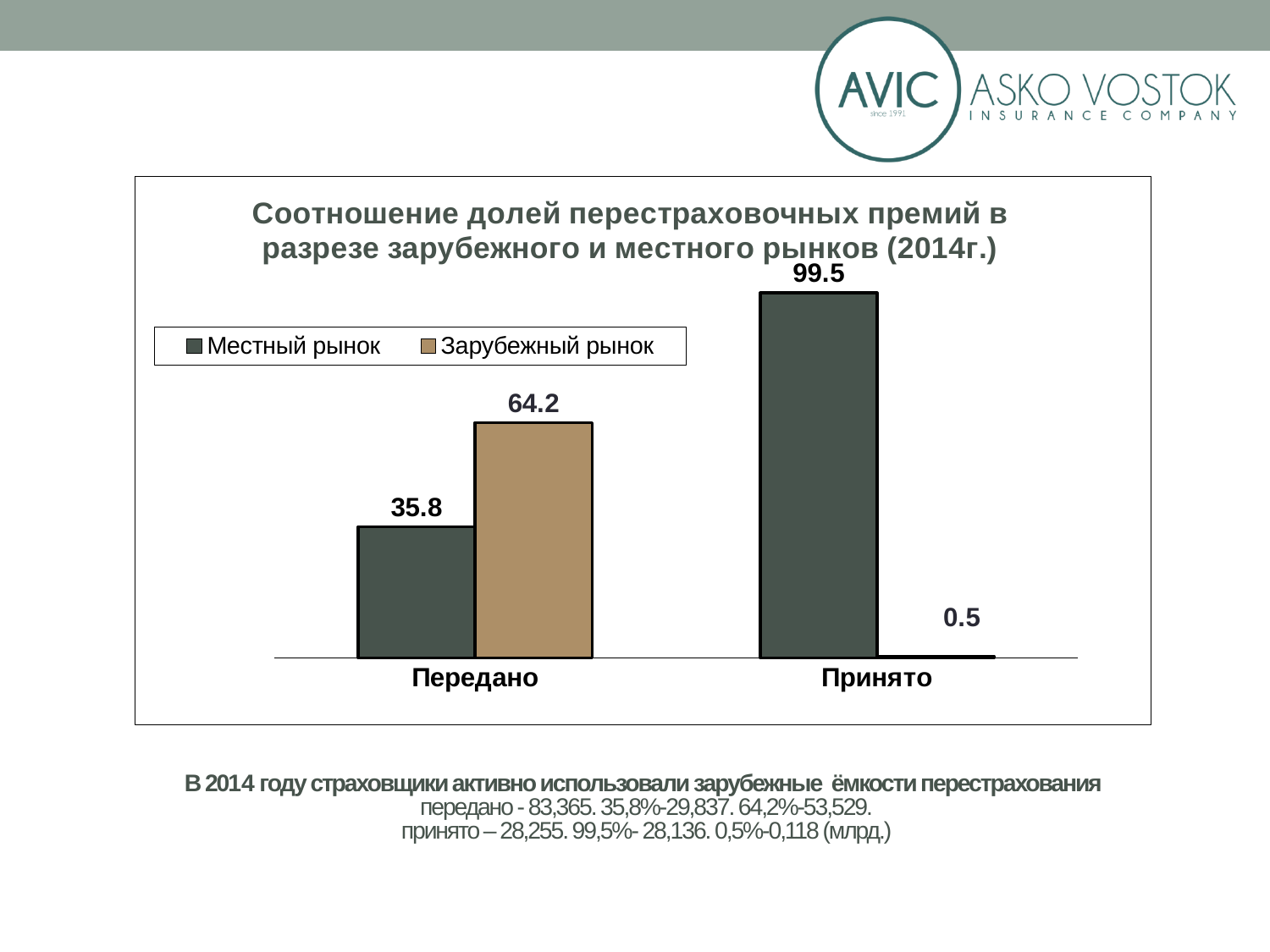
What is the value for Местный рынок in the Принято category? 99.5 In the Передано category, which series has the larger value, Местный рынок or Зарубежный рынок? Зарубежный рынок Which bar has the lowest value on the chart? Зарубежный рынок, Принято What kind of chart is shown on the slide? Bar chart What is the value for Местный рынок in the Передано category? 35.8 What is the difference between Зарубежный рынок and Местный рынок in the Передано category? 28.4 How many categories are shown on the x axis? 2 What is the difference between Местный рынок and Зарубежный рынок in the Принято category? 99.0 What is the value for Зарубежный рынок in the Принято category? 0.5 How many series does the legend list? 2 Which bar has the highest value on the chart? Местный рынок, Принято What is the value for Зарубежный рынок in the Передано category? 64.2